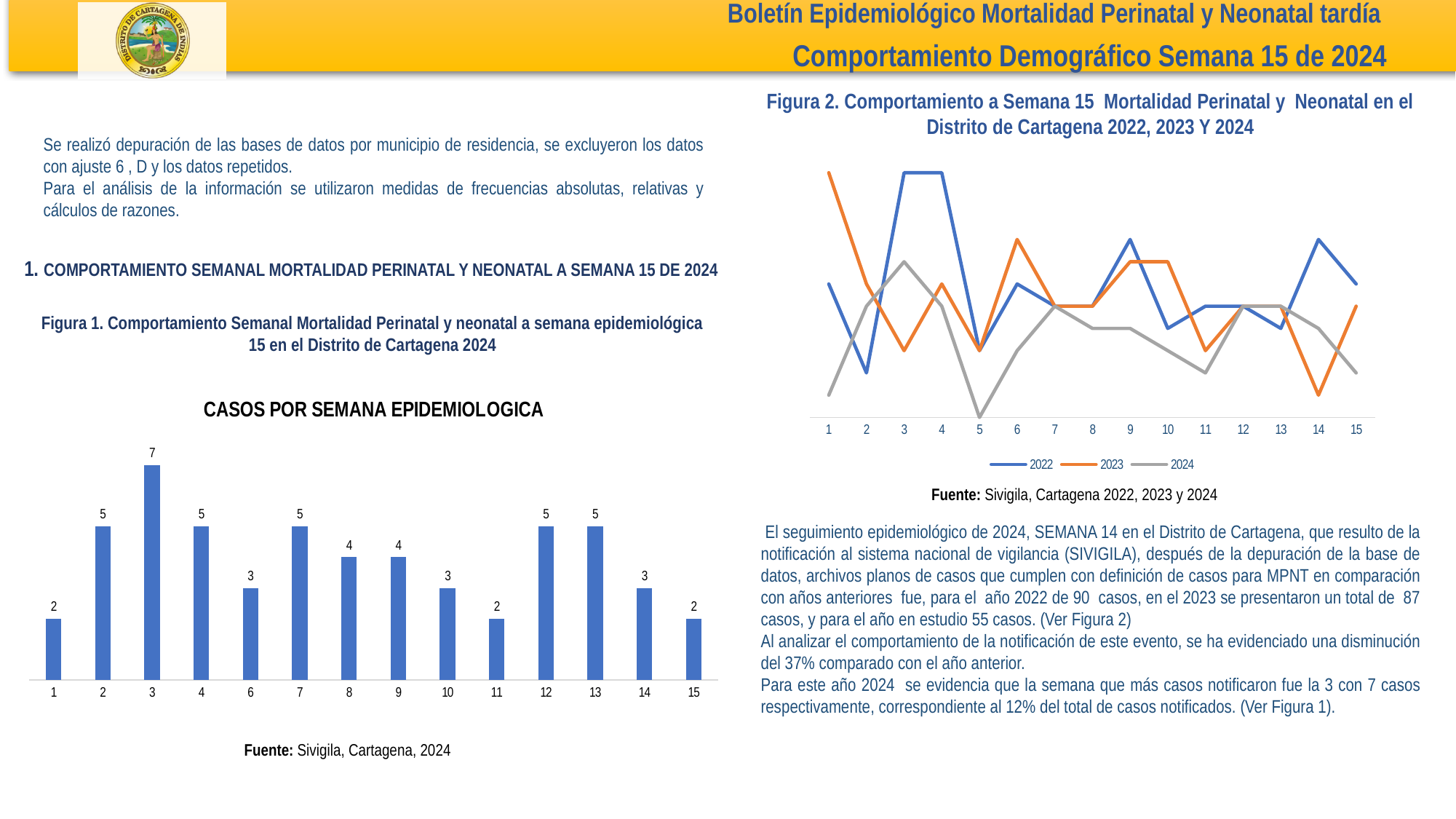
In the chart titled 'CASOS POR SEMANA EPIDEMIOLOGICA', what kind of chart is shown? bar chart In the Figura 2 line chart on the right, what are the legend entries? 2022, 2023, 2024 In the chart titled 'CASOS POR SEMANA EPIDEMIOLOGICA', what is the value for week 3? 7 In the chart titled 'CASOS POR SEMANA EPIDEMIOLOGICA', what is the value for week 8? 4 In the chart titled 'CASOS POR SEMANA EPIDEMIOLOGICA', which is larger, the value for week 2 or the value for week 6? week 2 In the chart titled 'CASOS POR SEMANA EPIDEMIOLOGICA', what is the difference between the values for week 3 and week 1? 5 In the chart titled 'CASOS POR SEMANA EPIDEMIOLOGICA', which week has the highest value? 3 In the chart titled 'CASOS POR SEMANA EPIDEMIOLOGICA', what is the value for week 15? 2 In the chart titled 'CASOS POR SEMANA EPIDEMIOLOGICA', how many bars are plotted? 14 In the Figura 2 line chart on the right, how many series does the legend list? 3 In the Figura 2 line chart on the right, what kind of chart is shown? line chart In the Figura 2 line chart on the right, which series has the highest value at week 1? 2023